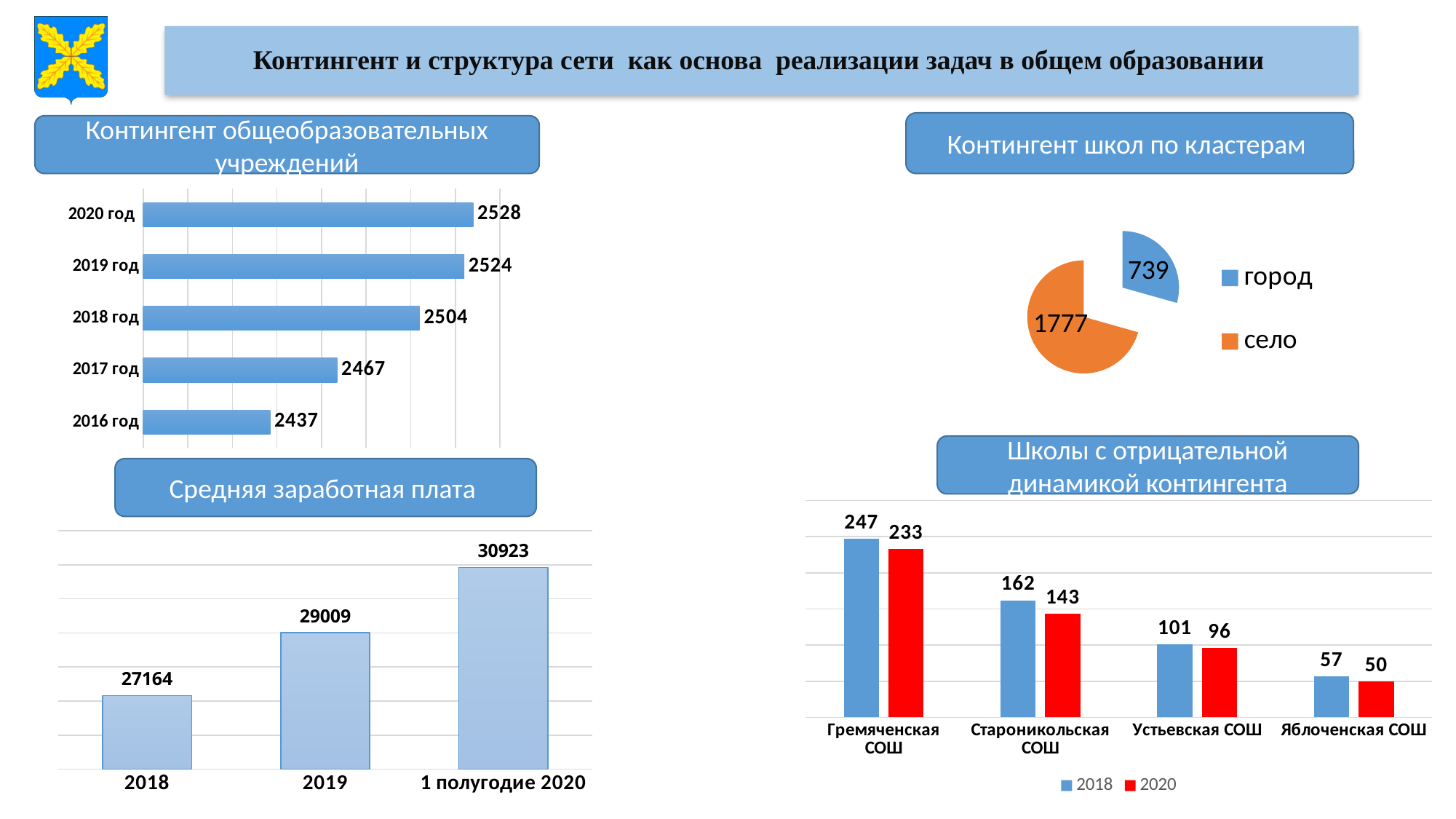
In the chart 'Контингент общеобразовательных учреждений', which year has the lowest value? 2016 год In the chart 'Средняя заработная плата', do the values rise or fall from 2018 to 1 полугодие 2020? rise In the chart 'Школы с отрицательной динамикой контингента', what is the 2020 value for Старониколькая СОШ? 143 In the chart 'Школы с отрицательной динамикой контингента', how many series does the legend list? 2 In the pie chart 'Контингент школ по кластерам', which category is larger, город or село? село In the chart 'Контингент общеобразовательных учреждений', what is the value for 2020 год? 2528 In the chart 'Контингент общеобразовательных учреждений', how many years are shown? 5 In the chart 'Контингент общеобразовательных учреждений', what is the difference between the values for 2020 год and 2016 год? 91 In the pie chart 'Контингент школ по кластерам', what is the value for село? 1777 In the chart 'Средняя заработная плата', what is the difference between the values for 2019 and 2018? 1845 What kind of chart is 'Школы с отрицательной динамикой контингента'? bar chart In the chart 'Средняя заработная плата', what is the value for 2019? 29009